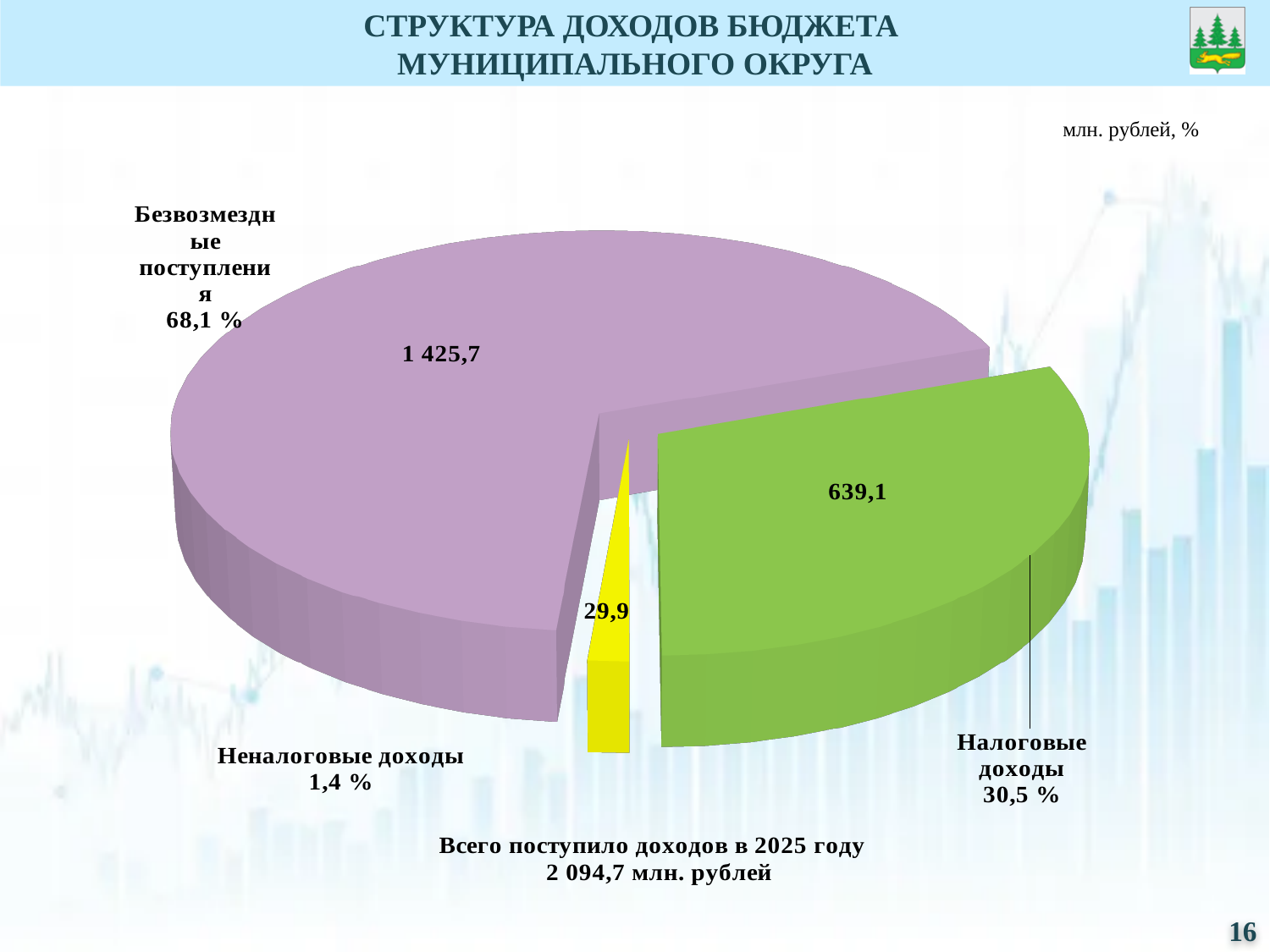
Which category has the smallest slice of the pie? Неналоговые доходы What kind of chart is shown on the slide? Pie chart What is the value for Безвозмездные поступления? 1 425,7 What is the difference between the values for Безвозмездные поступления and Налоговые доходы? 786,6 What share of the pie do Неналоговые доходы make up? 1,4 % What share of the pie do Безвозмездные поступления make up? 68,1 % What is the value for Неналоговые доходы? 29,9 How many slices does the pie chart have? 3 Which is larger, Налоговые доходы or Неналоговые доходы? Налоговые доходы What is the value for Налоговые доходы? 639,1 What share of the pie do Налоговые доходы make up? 30,5 % Which category has the largest slice of the pie? Безвозмездные поступления